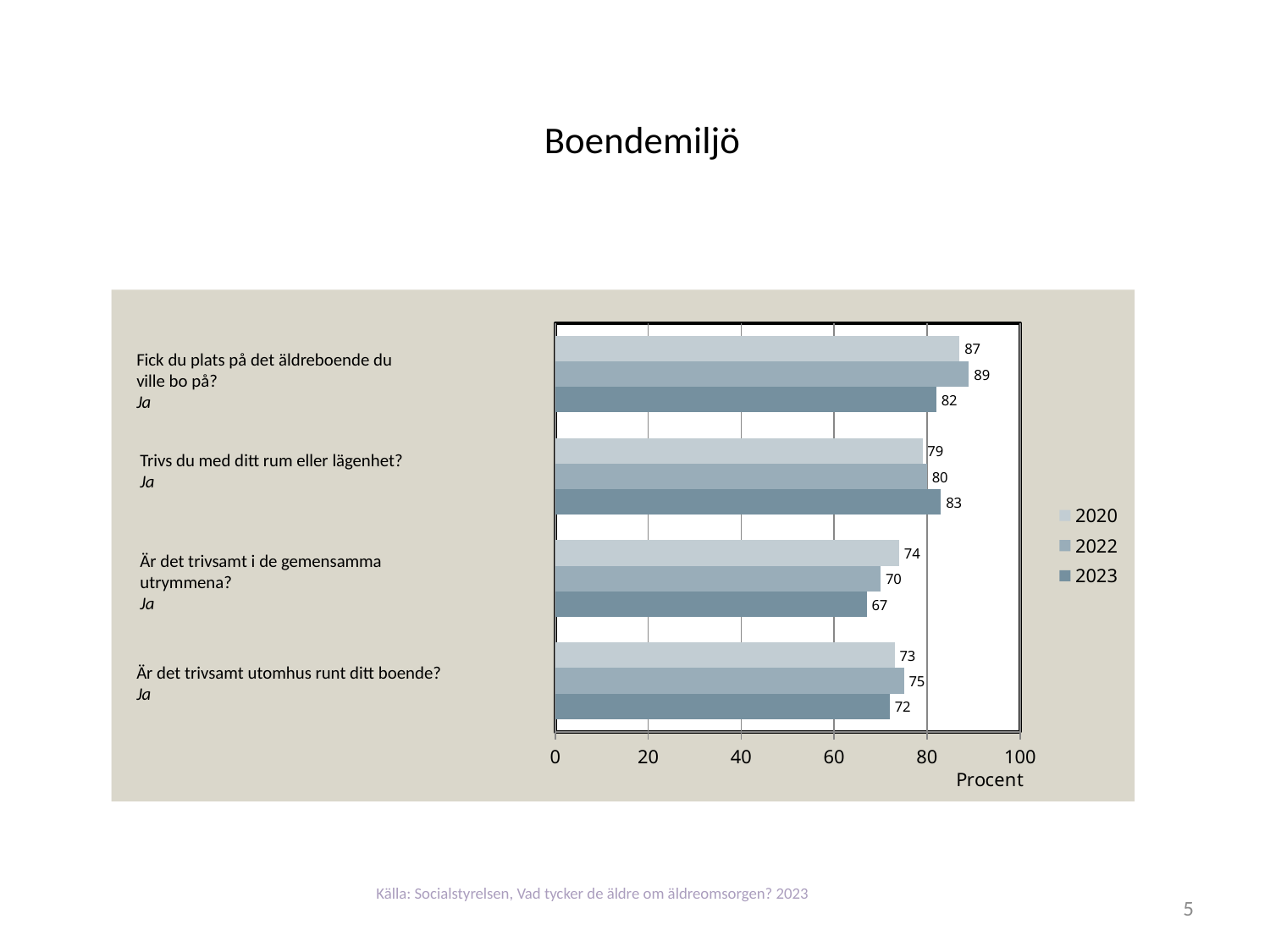
Which year has the highest value for "Fick du plats på det äldreboende du ville bo på?"? 2022 What type of chart is shown on the slide? bar chart How many series does the legend list? 3 What is the 2020 value for "Är det trivsamt i de gemensamma utrymmena?"? 74 For "Är det trivsamt utomhus runt ditt boende?", is the 2022 value or the 2020 value larger? 2022 What is the 2023 value for "Trivs du med ditt rum eller lägenhet?"? 83 What is the 2023 value for "Är det trivsamt utomhus runt ditt boende?"? 72 How many question categories are plotted in the chart? 4 Which year has the lowest value for "Är det trivsamt i de gemensamma utrymmena?"? 2023 What is the 2022 value for "Fick du plats på det äldreboende du ville bo på?"? 89 What is the difference between the 2022 and 2023 values for "Fick du plats på det äldreboende du ville bo på?"? 7 What label is shown on the horizontal axis of the chart? Procent